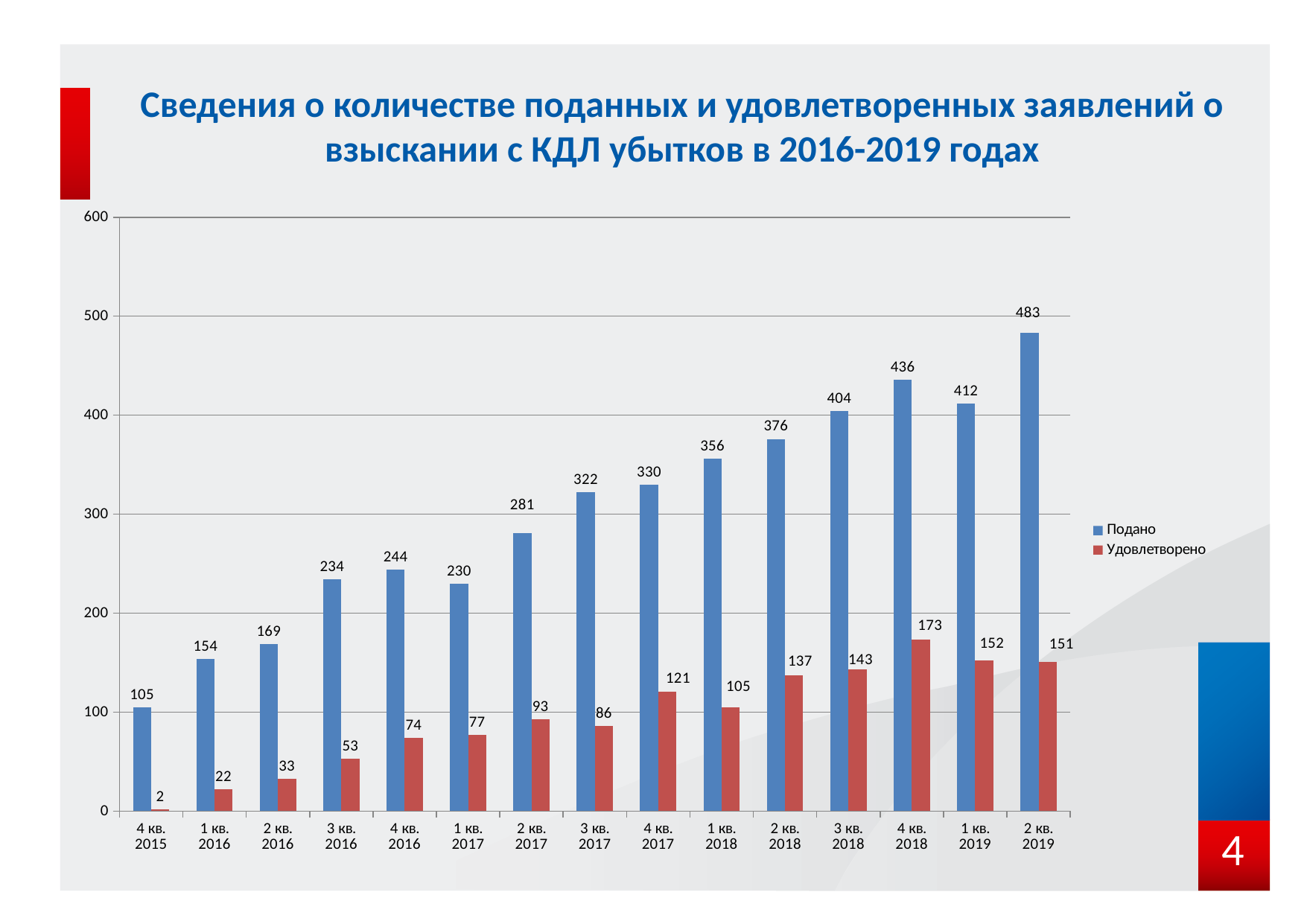
What is the value of Удовлетворено for 4 кв. 2018? 173 Is the Подано value for 3 кв. 2018 greater or less than 400? greater What kind of chart is shown on the slide? bar chart Which colour represents the Удовлетворено series? red What is the value of Подано for 1 кв. 2017? 230 Which quarter has the highest Подано value? 2 кв. 2019 Which quarter has the lowest Удовлетворено value? 4 кв. 2015 How many quarters are shown on the x axis? 15 How many series does the legend list? 2 Which is larger: Подано for 4 кв. 2018 or Подано for 1 кв. 2019? 4 кв. 2018 What is the difference between Подано and Удовлетворено for 2 кв. 2018? 239 What is the value of Подано for 2 кв. 2019? 483